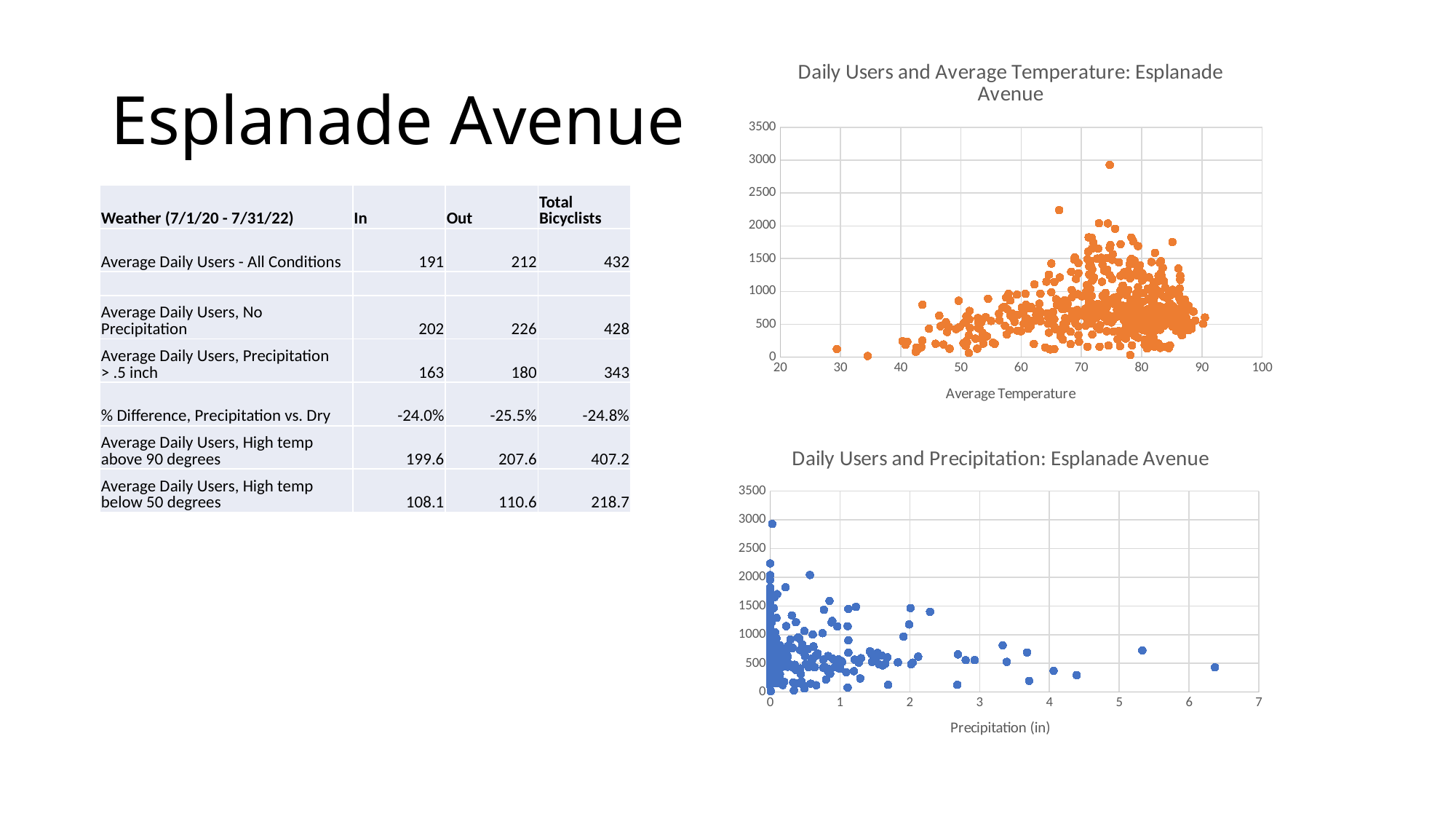
What kind of chart is the top chart, 'Daily Users and Average Temperature: Esplanade Avenue'? scatter chart What kind of chart is the bottom chart, 'Daily Users and Precipitation: Esplanade Avenue'? scatter chart In the top chart, is the value of the highest point greater or less than 3000? less In the top chart, is the value of the highest point greater or less than 2500? greater In the bottom chart, what is the label of the x axis? Precipitation (in) In the bottom chart, is the value of the point with the highest precipitation (just over 6 inches) greater or less than 500? less In the bottom chart, do daily user values generally rise or fall as precipitation increases along the x axis? fall In the bottom chart, is the highest point located at the low end or the high end of the precipitation axis? low end In the top chart, what is the label of the x axis? Average Temperature